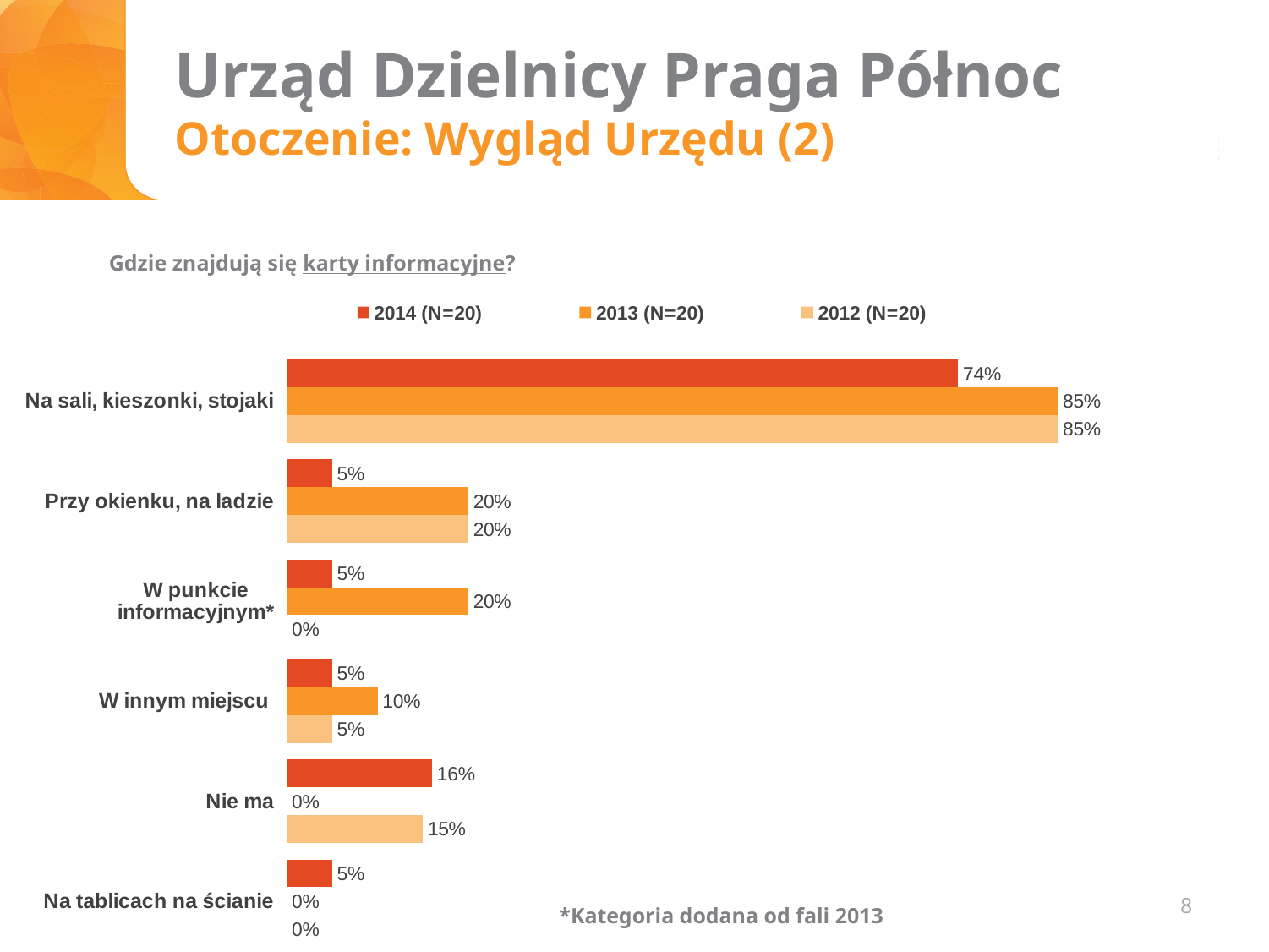
Which is larger for 'Nie ma': the 2014 (N=20) value or the 2012 (N=20) value? 2014 (N=20) What question does the chart answer, as stated above the chart? Gdzie znajdują się karty informacyjne? What is the value for 'Nie ma' in the 2012 (N=20) series? 15% How many series does the legend list? 3 How many categories are shown on the chart? 6 What is the value for 'Na sali, kieszonki, stojaki' in the 2014 (N=20) series? 74% What is the difference between the 2013 (N=20) and 2014 (N=20) values for 'Na sali, kieszonki, stojaki'? 11% What is the value for 'W punkcie informacyjnym*' in the 2012 (N=20) series? 0% Which category has the highest value in the 2014 (N=20) series? Na sali, kieszonki, stojaki Which category has the lowest value in the 2013 (N=20) series? Nie ma and Na tablicach na ścianie (both 0%) What is the value for 'Przy okienku, na ladzie' in the 2013 (N=20) series? 20% What kind of chart is shown on the slide? Bar chart